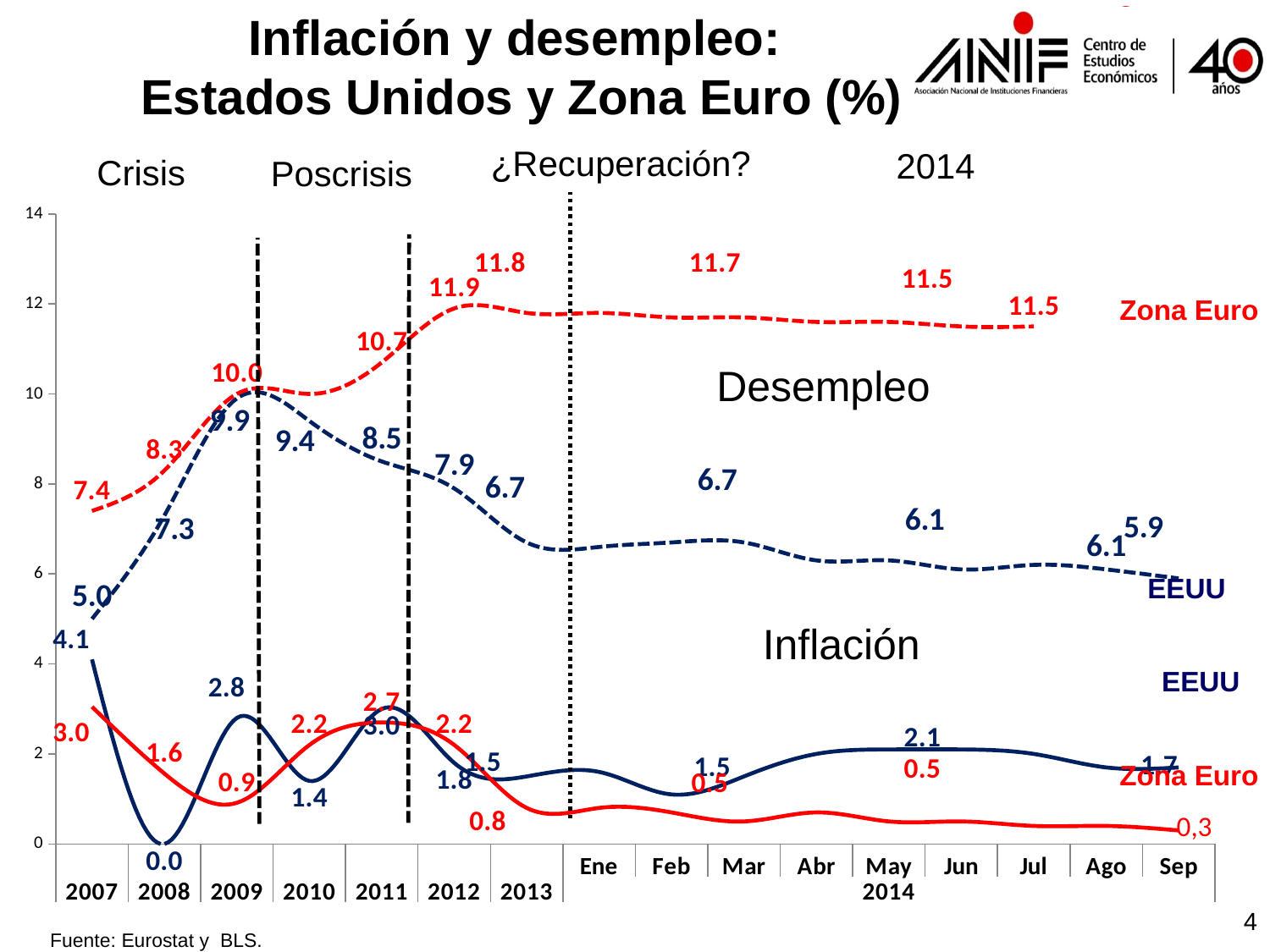
What was the EEUU inflation rate (Inflación) in 2008? 0.0 In which year did the Zona Euro unemployment rate (Desempleo) reach its highest labelled value? 2012 What was the EEUU unemployment rate (Desempleo) in 2009? 9.9 In 2007, which was higher: EEUU inflation or Zona Euro inflation? EEUU inflation What was the Zona Euro inflation rate (Inflación) in Sep 2014? 0,3 What sources are cited for the chart data? Eurostat y BLS Did the EEUU unemployment rate (Desempleo) rise or fall from 2009 to Sep 2014? Fall What kind of chart is shown on the slide? Line chart What was the Zona Euro unemployment rate (Desempleo) in 2007? 7.4 What was the EEUU unemployment rate (Desempleo) in Sep 2014? 5.9 What is the difference between the EEUU unemployment rate in 2007 and in 2009? 4.9 What is the difference between the Zona Euro and EEUU unemployment rates (Desempleo) in 2012? 4.0